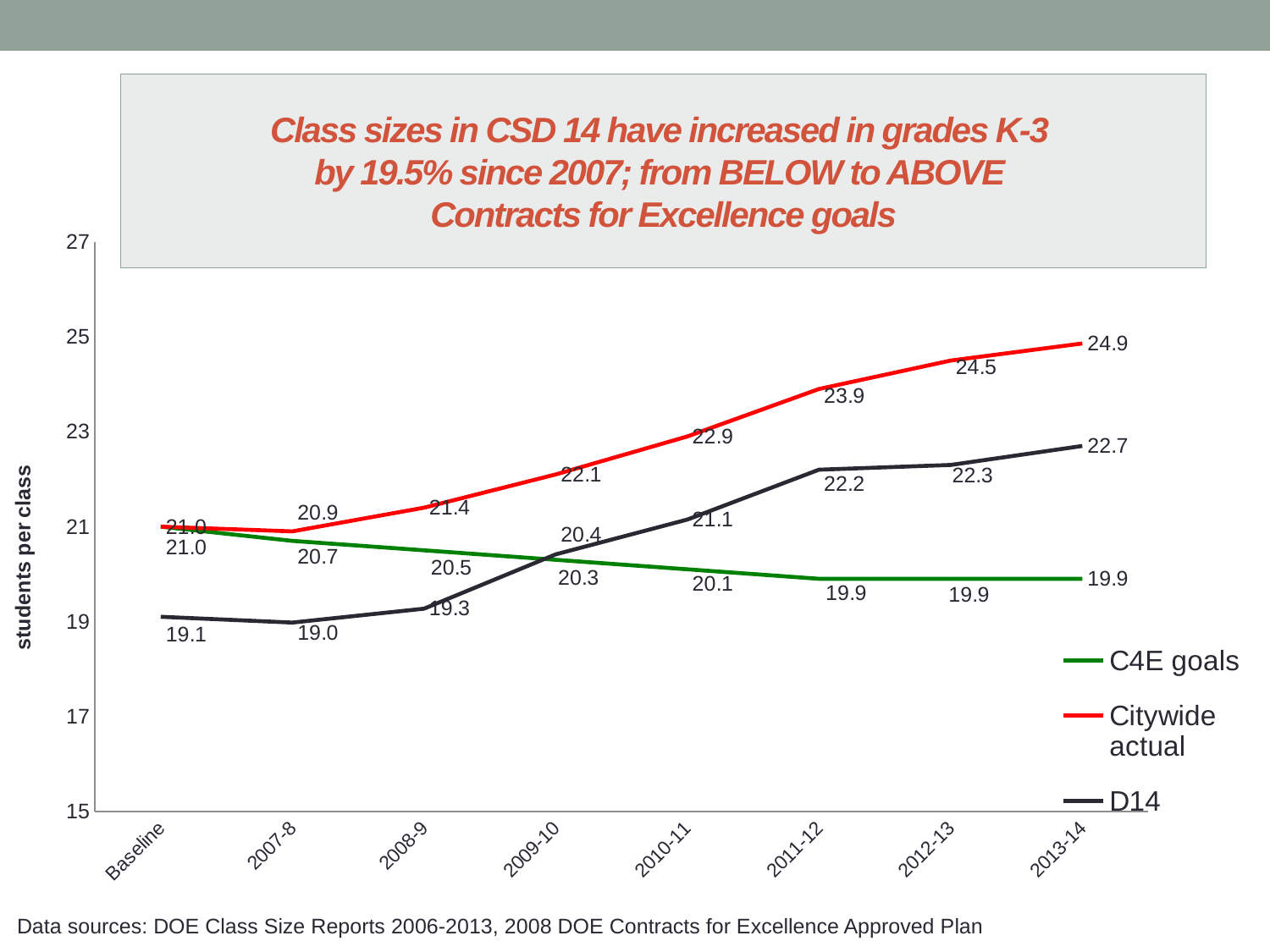
What is the Citywide actual value for 2013-14? 24.9 What is the C4E goals value for 2011-12? 19.9 Which series has the highest value in 2013-14? Citywide actual Is the Citywide actual value for 2012-13 greater or less than 23? greater How many time points are plotted on the x axis? 8 How many series does the legend list? 3 In 2010-11, which is larger: the D14 value or the C4E goals value? D14 What is the difference between the Citywide actual and D14 values in 2013-14? 2.2 What is the D14 value at Baseline? 19.1 What kind of chart is shown on the slide? line chart In which year is the D14 value lowest? 2007-8 By how much did the D14 value increase from Baseline to 2013-14? 3.6